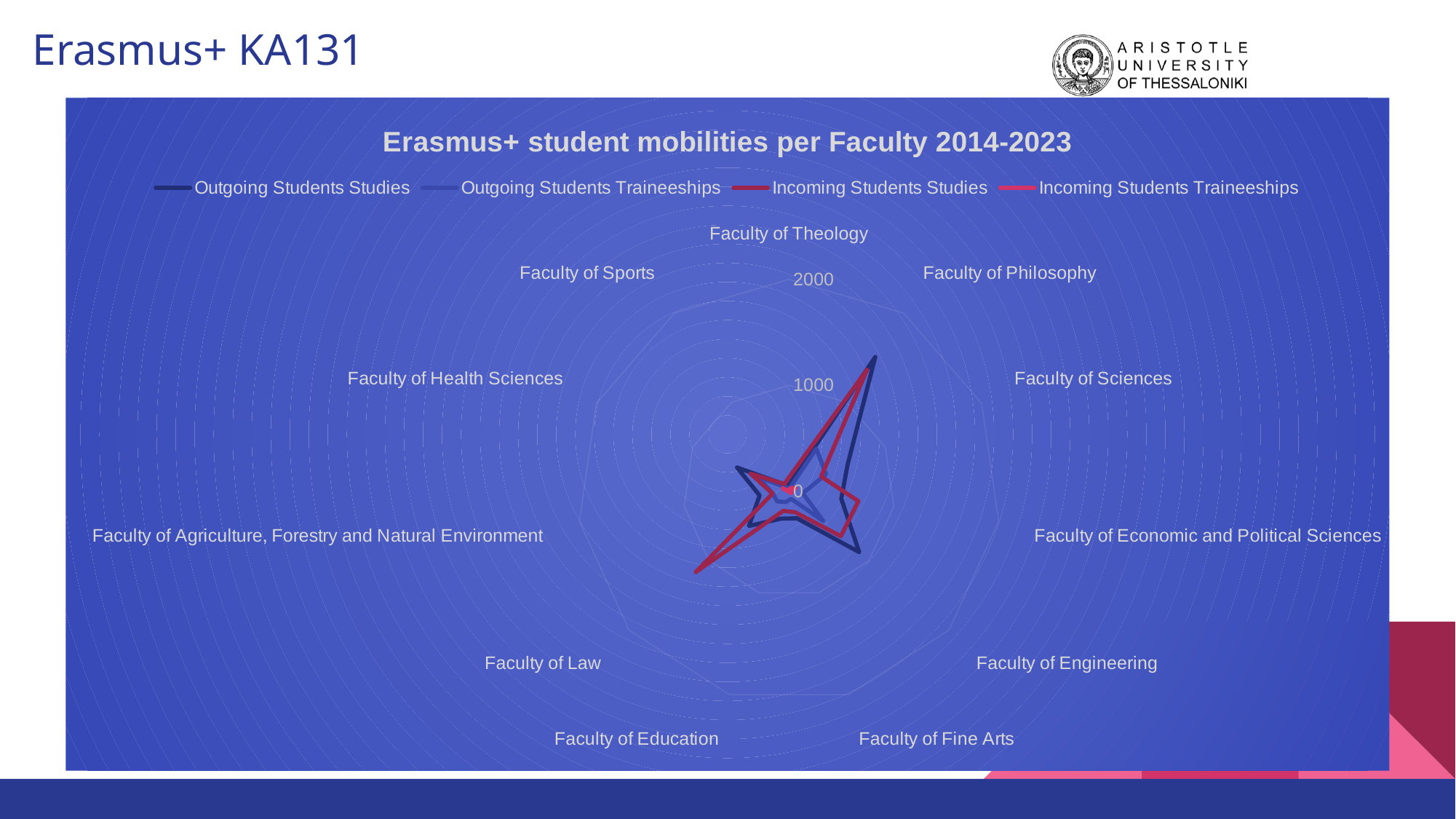
Is the Outgoing Students Studies value for the Faculty of Philosophy greater or less than 1000? greater Which faculty has the highest value for Outgoing Students Studies? Faculty of Philosophy What type of chart is shown on the slide? Radar chart Is the Incoming Students Studies value for the Faculty of Law greater or less than 1000? greater What is the title of the chart? Erasmus+ student mobilities per Faculty 2014-2023 Is the Outgoing Students Studies value for the Faculty of Philosophy greater or less than 2000? less How many series does the legend list? 4 Which series is listed first in the legend? Outgoing Students Studies How many faculties are plotted on the chart? 11 Which is larger for Outgoing Students Studies: the Faculty of Philosophy or the Faculty of Engineering? Faculty of Philosophy